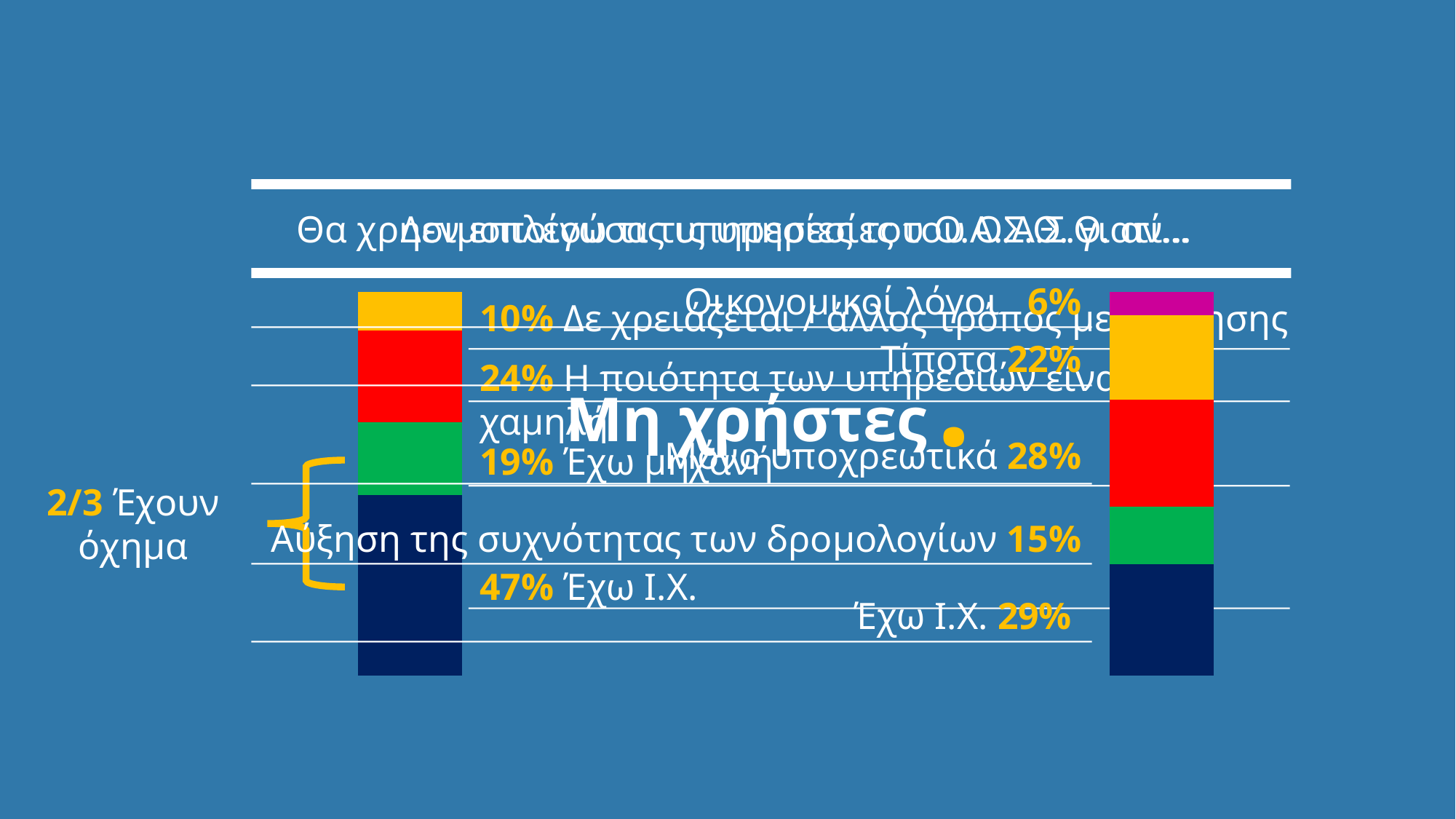
In the left stacked bar, what is the smallest percentage shown? 10% What type of chart is shown on the slide? Stacked bar chart In the right stacked bar, what percentage is shown for "Έχω Ι.Χ."? 29% What is the difference between the "Έχω Ι.Χ." percentage in the left bar and in the right bar? 18 percentage points How many segments does the right stacked bar have? 5 In the left stacked bar, which segment has the largest percentage? Έχω Ι.Χ. (47%) In the right stacked bar, what percentage is shown for "Τίποτα"? 22% In the left stacked bar, what percentage is shown for "Έχω Ι.Χ."? 47% In the left stacked bar, what percentage is shown for "Έχω μηχανή"? 19% In the right stacked bar, what percentage is shown for "Αύξηση της συχνότητας των δρομολογίων"? 15% Which bar shows a larger percentage for "Έχω Ι.Χ.", the left bar or the right bar? The left bar In the right stacked bar, what percentage is shown for "Οικονομικοί λόγοι"? 6%